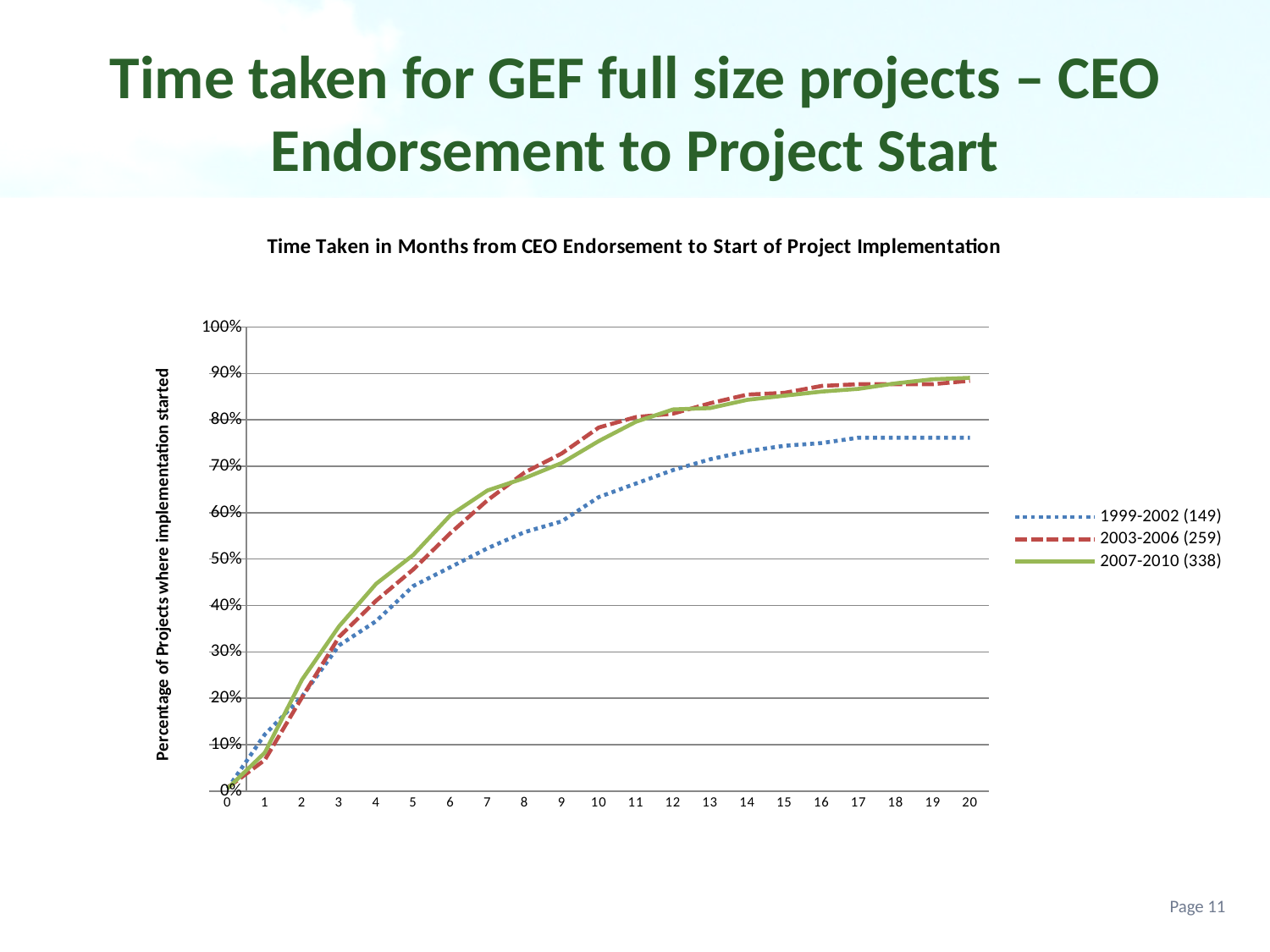
Which series has the lowest value at month 20? 1999-2002 (149) What is the title of the chart? Time Taken in Months from CEO Endorsement to Start of Project Implementation How many series does the legend list? 3 Is the value for the 2003-2006 (259) series at month 10 greater or less than 70%? greater At month 15, which is larger: the value for 2003-2006 (259) or the value for 1999-2002 (149)? 2003-2006 (259) How many month values are marked along the x axis (from 0 to 20)? 21 What kind of chart is shown on the slide? Line chart Is the value for the 1999-2002 (149) series at month 5 greater or less than 50%? less Is the value for the 1999-2002 (149) series at month 20 greater or less than 80%? less What is the label of the y axis? Percentage of Projects where implementation started Do the values for the 2007-2010 (338) series rise or fall as the number of months increases? Rise